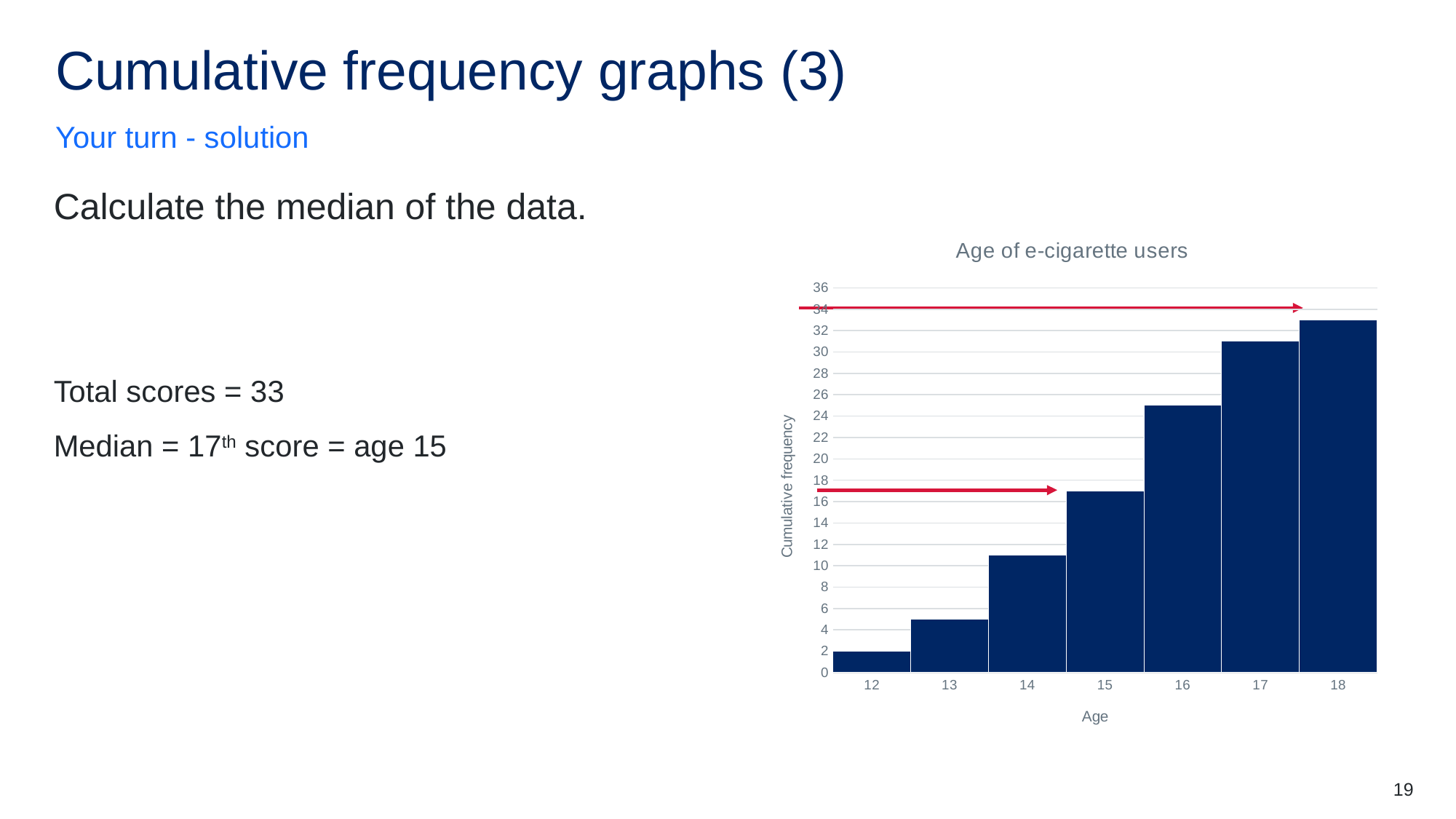
What is the title of the chart? Age of e-cigarette users Which age has the lowest cumulative frequency? 12 What kind of chart is shown on the slide? bar chart Which has the larger cumulative frequency, age 14 or age 15? age 15 Is the cumulative frequency for age 13 greater or less than 6? less Is the cumulative frequency for age 16 greater or less than 20? greater Is the cumulative frequency for age 14 greater or less than 10? greater How many age categories are plotted on the x axis? 7 Which age has the highest cumulative frequency? 18 What is the cumulative frequency for age 12? 2 Do the cumulative frequency values rise or fall as age increases from 12 to 18? rise